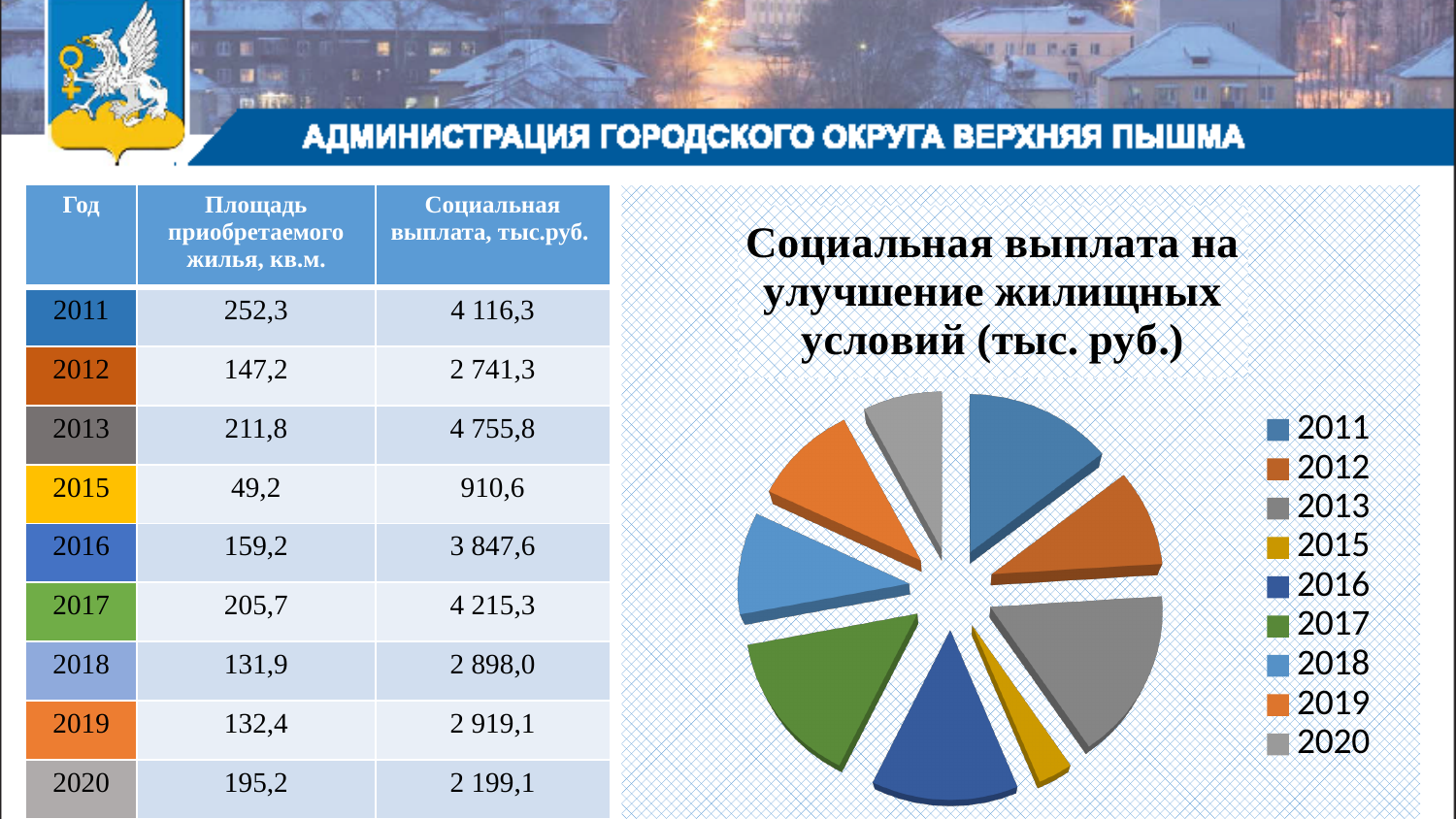
Which year has the larger slice in the pie chart, 2016 or 2015? 2016 How many years does the legend of the pie chart list? 9 Which colour represents 2015 in the pie chart legend? yellow What kind of chart is shown on the slide? pie chart Which year has the smallest slice in the pie chart? 2015 According to the table, what is the social payment (тыс.руб.) for 2015? 910,6 What is the difference between the social payments for 2019 and 2018 (тыс.руб.)? 21,1 Which year has the larger social payment, 2011 or 2012? 2011 What is the title of the pie chart? Социальная выплата на улучшение жилищных условий (тыс. руб.) How many slices does the pie chart have? 9 According to the table, what is the area of purchased housing (кв.м.) in 2020? 195,2 According to the table, what is the social payment (тыс.руб.) for 2013? 4 755,8